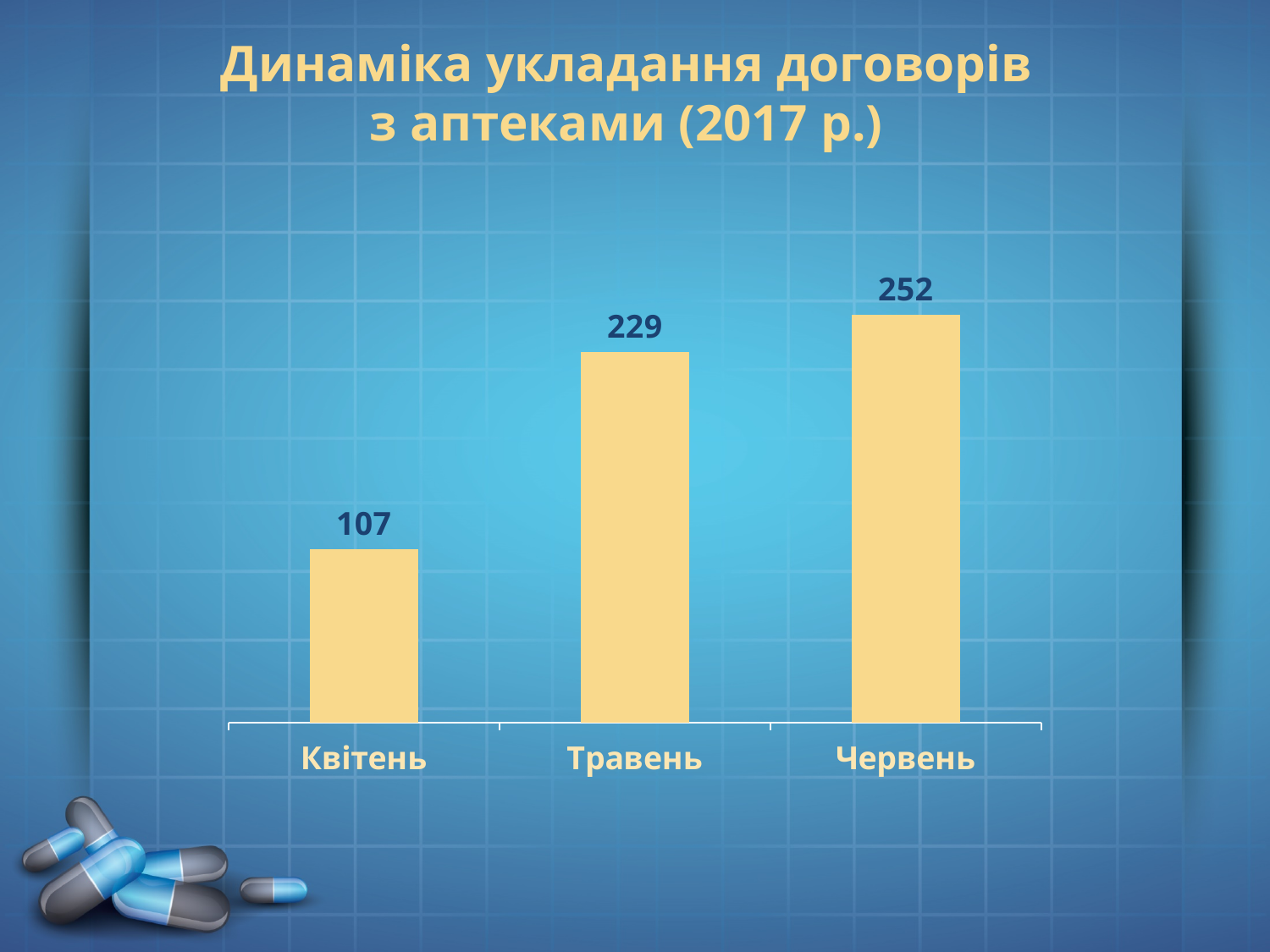
Which is larger, the value for Квітень or the value for Травень? Травень What is the value for Червень? 252 Which month has the highest value? Червень What is the difference between the values for Травень and Квітень? 122 How many months are shown on the chart? 3 What is the difference between the values for Червень and Травень? 23 What is the title of the chart? Динаміка укладання договорів з аптеками (2017 р.) What is the value for Квітень? 107 Which month has the lowest value? Квітень Do the values rise or fall from Квітень to Червень? rise What is the value for Травень? 229 What kind of chart is shown on the slide? bar chart